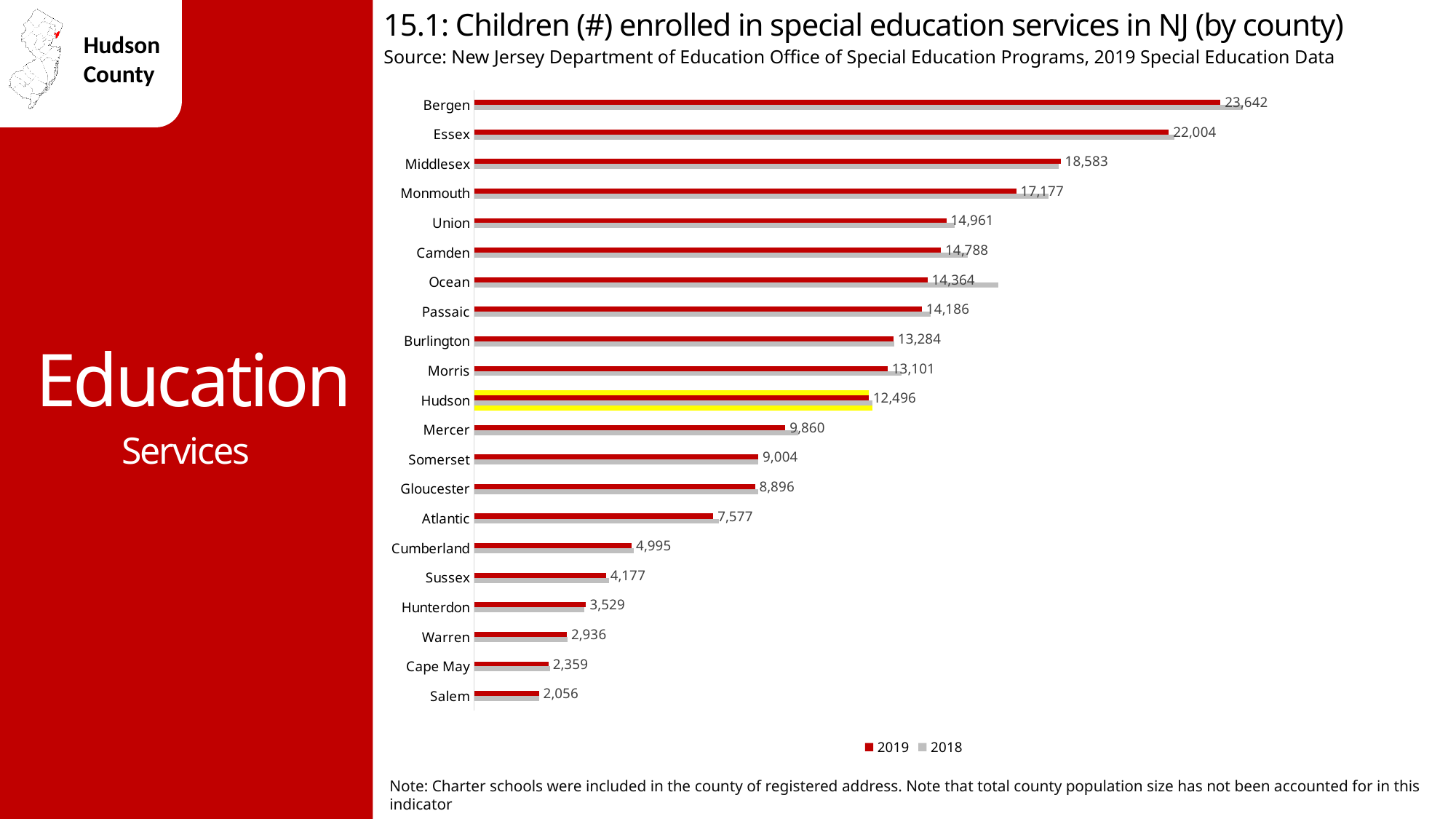
Which county's bars are highlighted in yellow on the chart? Hudson What is the difference between the 2019 values for Bergen and Essex? 1,638 How many series does the legend list? 2 Which county has the lowest number of children enrolled in special education services in 2019? Salem What type of chart is shown on the slide? bar chart What is the 2019 value for Hudson County? 12,496 What is the difference between the 2019 values for Hudson and Mercer? 2,636 What is the 2019 value for Salem County? 2,056 Which county has the highest number of children enrolled in special education services in 2019? Bergen How many counties are shown in the chart? 21 For Ocean County, which year's bar is longer, 2018 or 2019? 2018 What is the 2019 value for Bergen County? 23,642